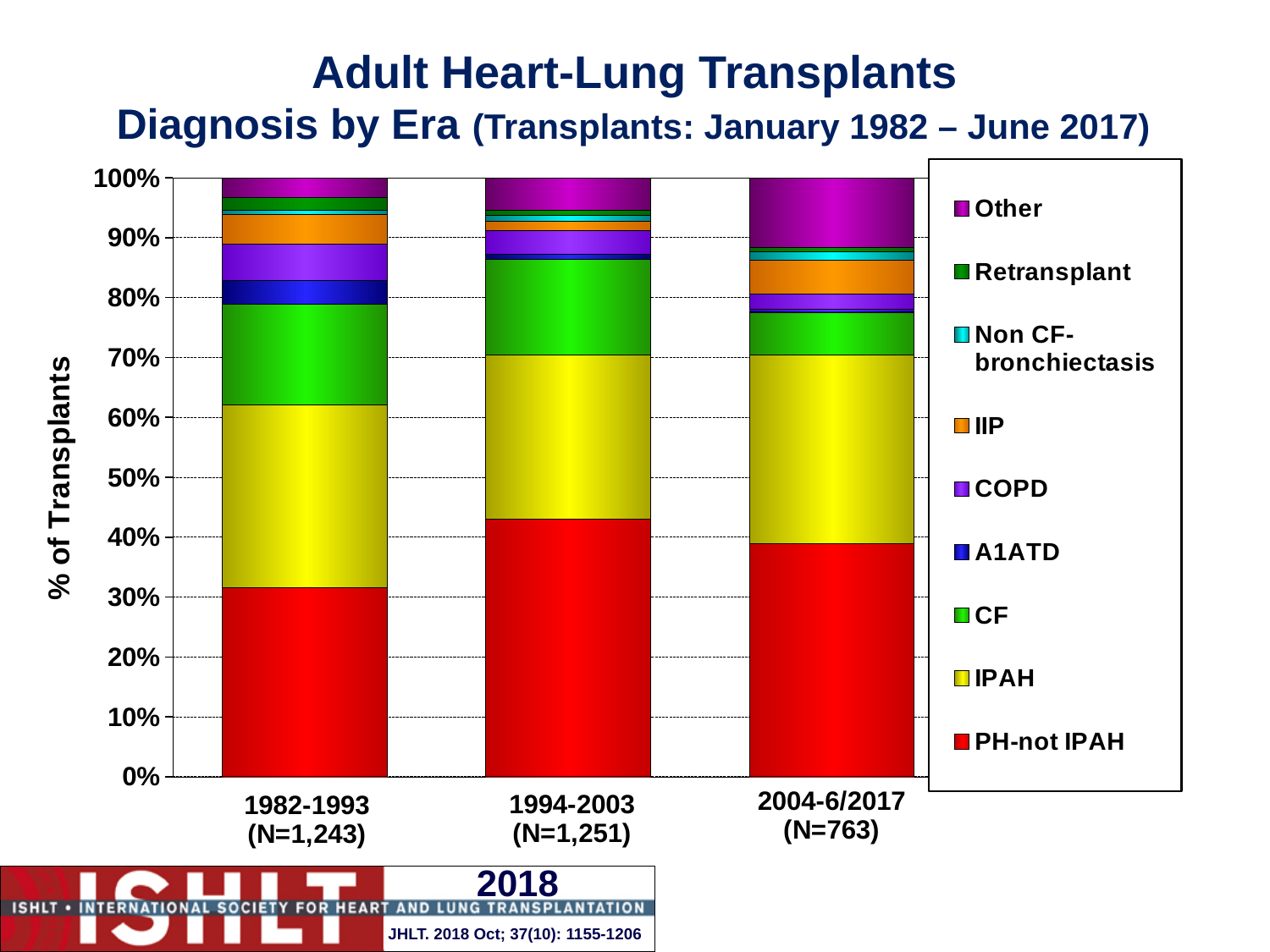
Which era has the smallest number of transplants (N) in its axis label? 2004-6/2017 (N=763) What kind of chart is shown on the slide? Stacked bar chart Which era has the largest number of transplants (N) in its axis label? 1994-2003 (N=1,251) How many era categories are shown on the x axis? 3 Is the PH-not IPAH share for 1982-1993 greater or less than 40%? less Is the PH-not IPAH share for 1994-2003 greater or less than 40%? greater What is the N value shown for the 2004-6/2017 era? N=763 How many diagnosis series does the legend list? 9 What is the N value shown for the 1982-1993 era? N=1,243 What is the label on the y axis? % of Transplants Which era has the larger PH-not IPAH share, 1982-1993 or 1994-2003? 1994-2003 In which era is the Other segment the largest? 2004-6/2017